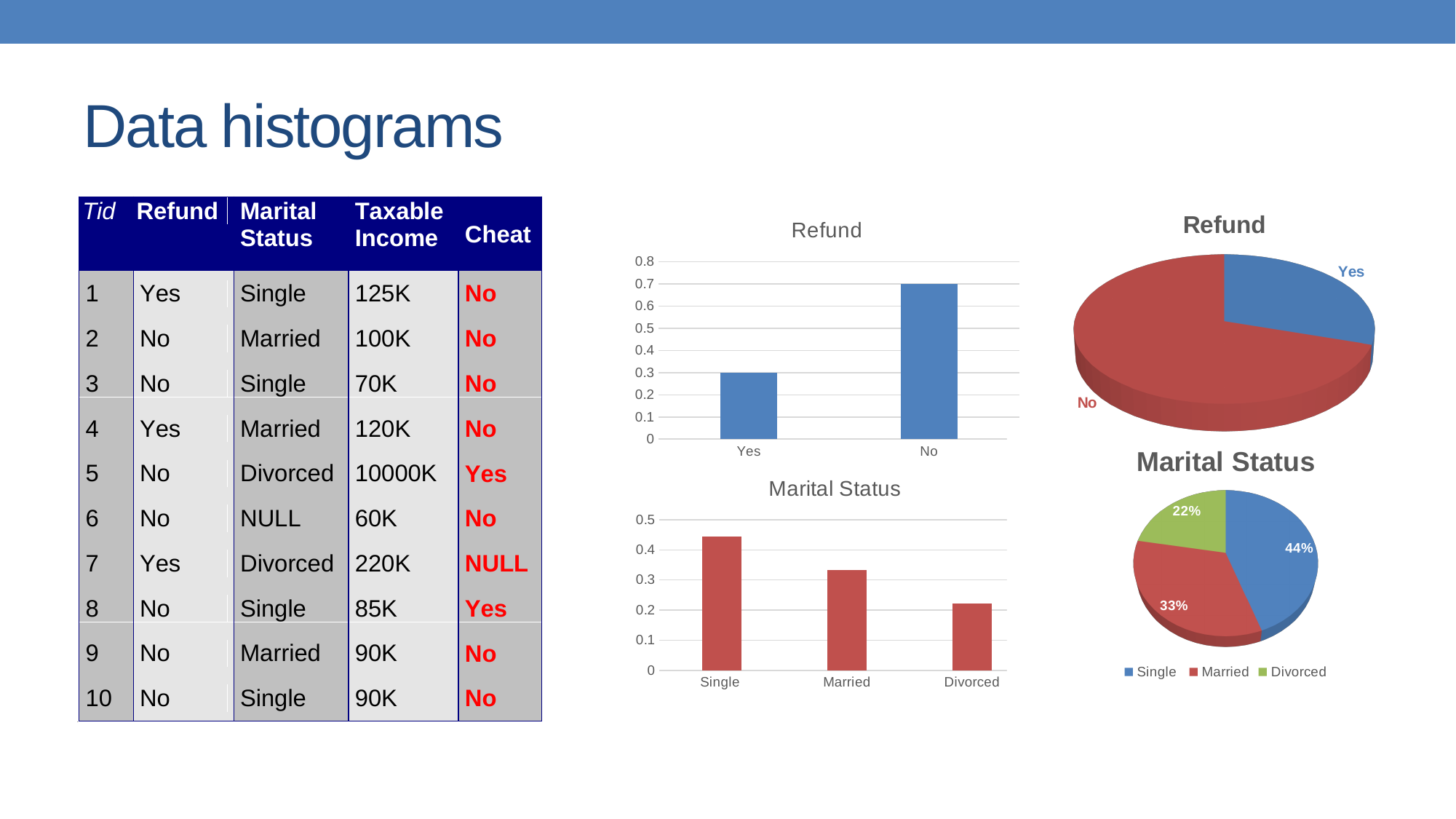
In the Refund bar chart, what is the difference between the values for No and Yes? 0.4 In the Refund bar chart, what is the value for Yes? 0.3 In the Marital Status bar chart, is the value for Divorced greater or less than 0.3? less In the Marital Status bar chart, do the values rise or fall from Single to Divorced? fall In the Marital Status bar chart, which category has the lowest value? Divorced In the Refund bar chart, what is the value for No? 0.7 In the Marital Status pie chart, what share does Married have? 33% In the Marital Status pie chart, which slice is the largest? Single In the Refund bar chart, which category has the highest value? No In the Refund pie chart, which slice is larger, Yes or No? No In the Marital Status bar chart, is the value for Single greater or less than 0.4? greater In the Marital Status bar chart, how many categories are shown on the x axis? 3